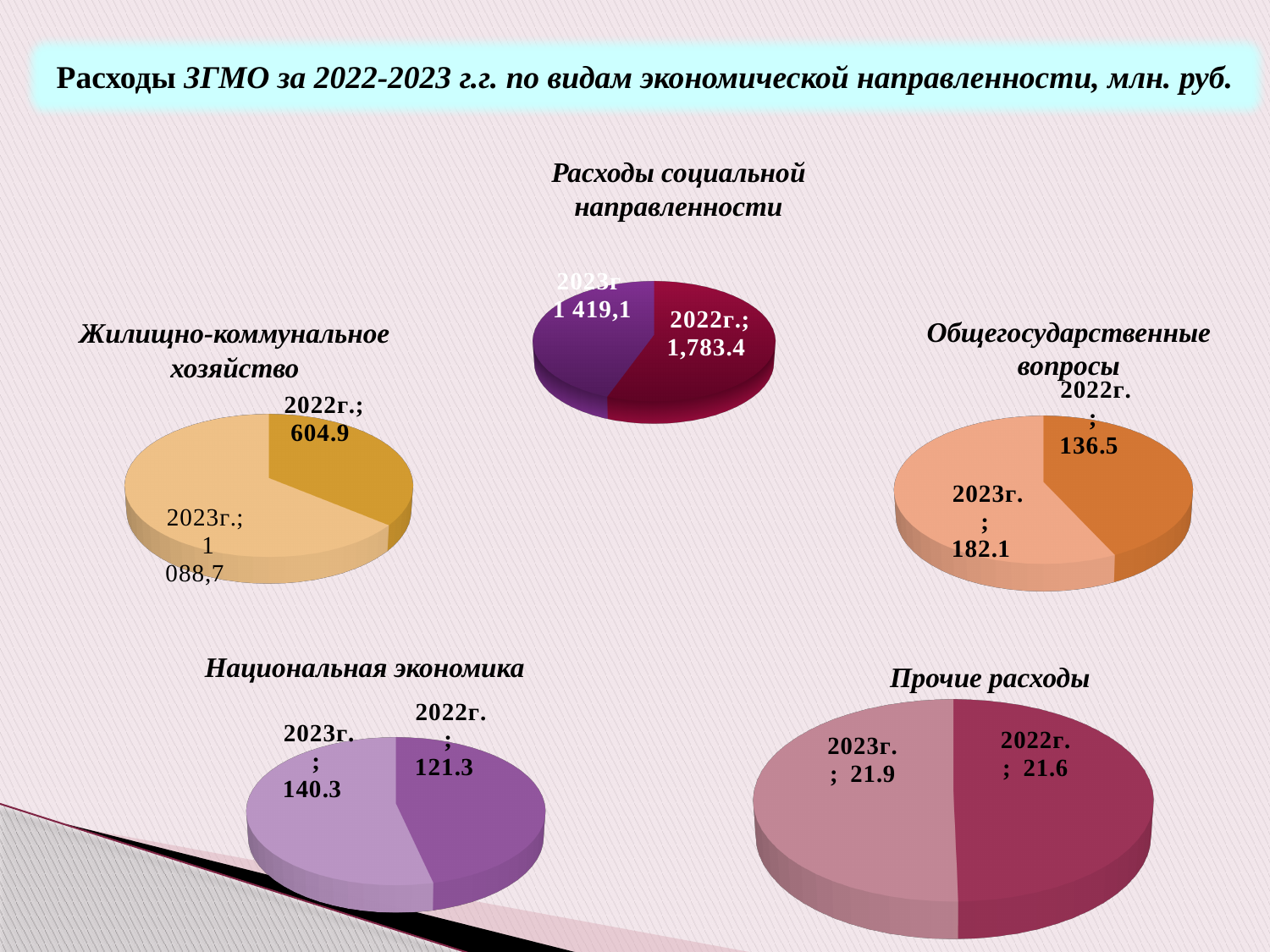
In the 'Жилищно-коммунальное хозяйство' chart, what is the value for 2023г.? 1 088,7 In the 'Общегосударственные вопросы' chart, what is the difference between the 2023г. and 2022г. values? 45.6 What kind of chart is used for 'Жилищно-коммунальное хозяйство'? Pie chart How many pie charts are shown on the slide? 5 In the 'Прочие расходы' chart, what is the value for 2023г.? 21.9 In the 'Национальная экономика' chart, what is the value for 2022г.? 121.3 In the 'Расходы социальной направленности' chart, what is the value for 2023г? 1 419,1 In the 'Прочие расходы' chart, what is the difference between the 2023г. and 2022г. values? 0.3 In the 'Жилищно-коммунальное хозяйство' chart, what is the value for 2022г.? 604.9 In the 'Национальная экономика' chart, which year has the larger value, 2022г. or 2023г.? 2023г. In the 'Расходы социальной направленности' chart, what is the value for 2022г.? 1,783.4 In the 'Общегосударственные вопросы' chart, what is the value for 2023г.? 182.1